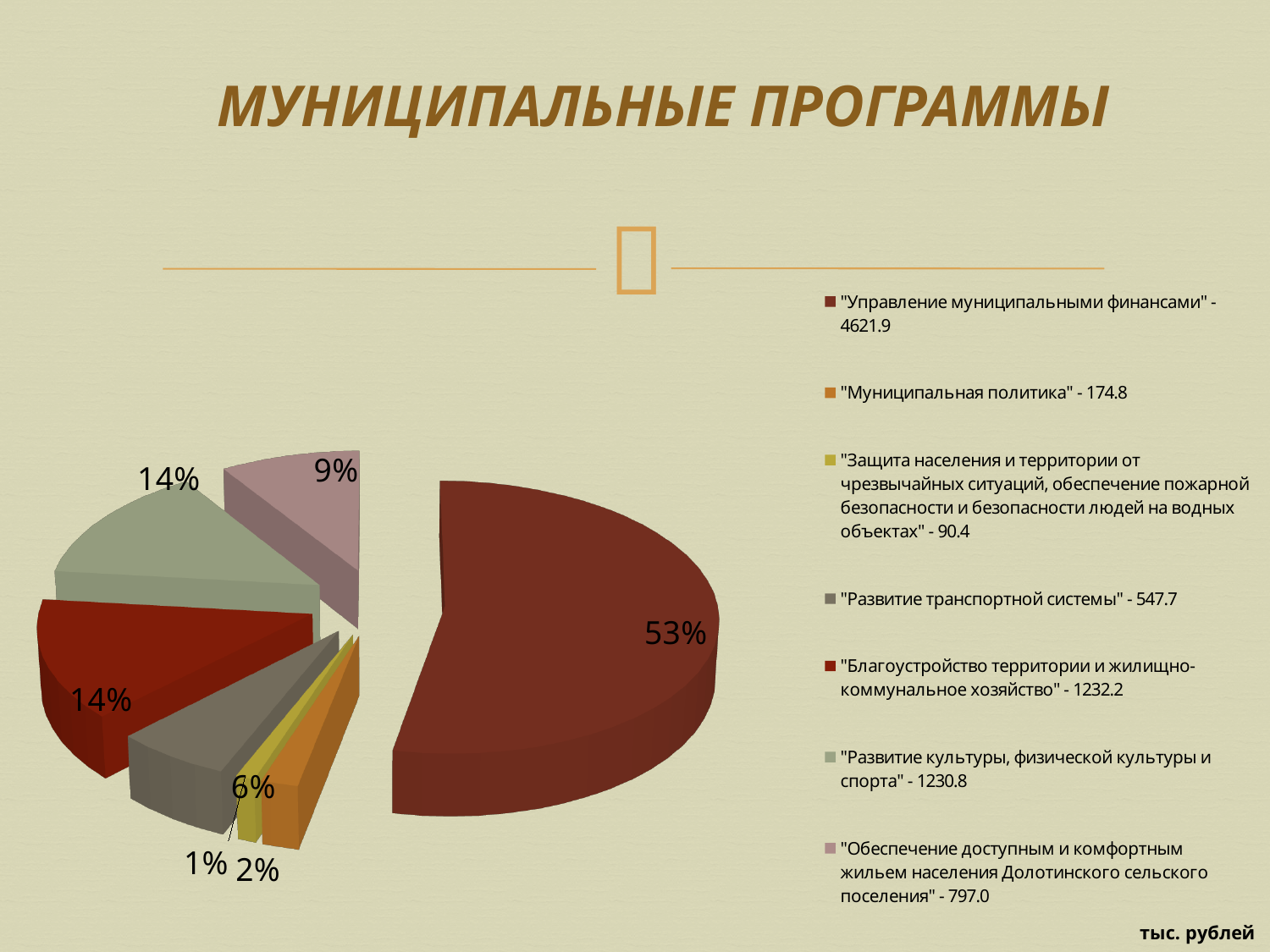
What share of the pie does "Развитие транспортной системы" take? 6% What share of the pie does "Управление муниципальными финансами" take? 53% What kind of chart is shown on the slide? pie chart What is the difference between the legend values for "Развитие транспортной системы" and "Муниципальная политика"? 372.9 What share of the pie does "Обеспечение доступным и комфортным жильем населения Долотинского сельского поселения" take? 9% How many categories does the pie chart have? 7 What value is listed in the legend for "Муниципальная политика"? 174.8 What value is listed in the legend for "Благоустройство территории и жилищно-коммунальное хозяйство"? 1232.2 Which category has the smallest share of the pie? "Защита населения и территории от чрезвычайных ситуаций, обеспечение пожарной безопасности и безопасности людей на водных объектах" Which category has the largest share of the pie? "Управление муниципальными финансами" In what units are the legend values given, according to the note at the bottom right of the slide? тыс. рублей Which has a larger legend value: "Развитие культуры, физической культуры и спорта" or "Обеспечение доступным и комфортным жильем населения Долотинского сельского поселения"? "Развитие культуры, физической культуры и спорта"